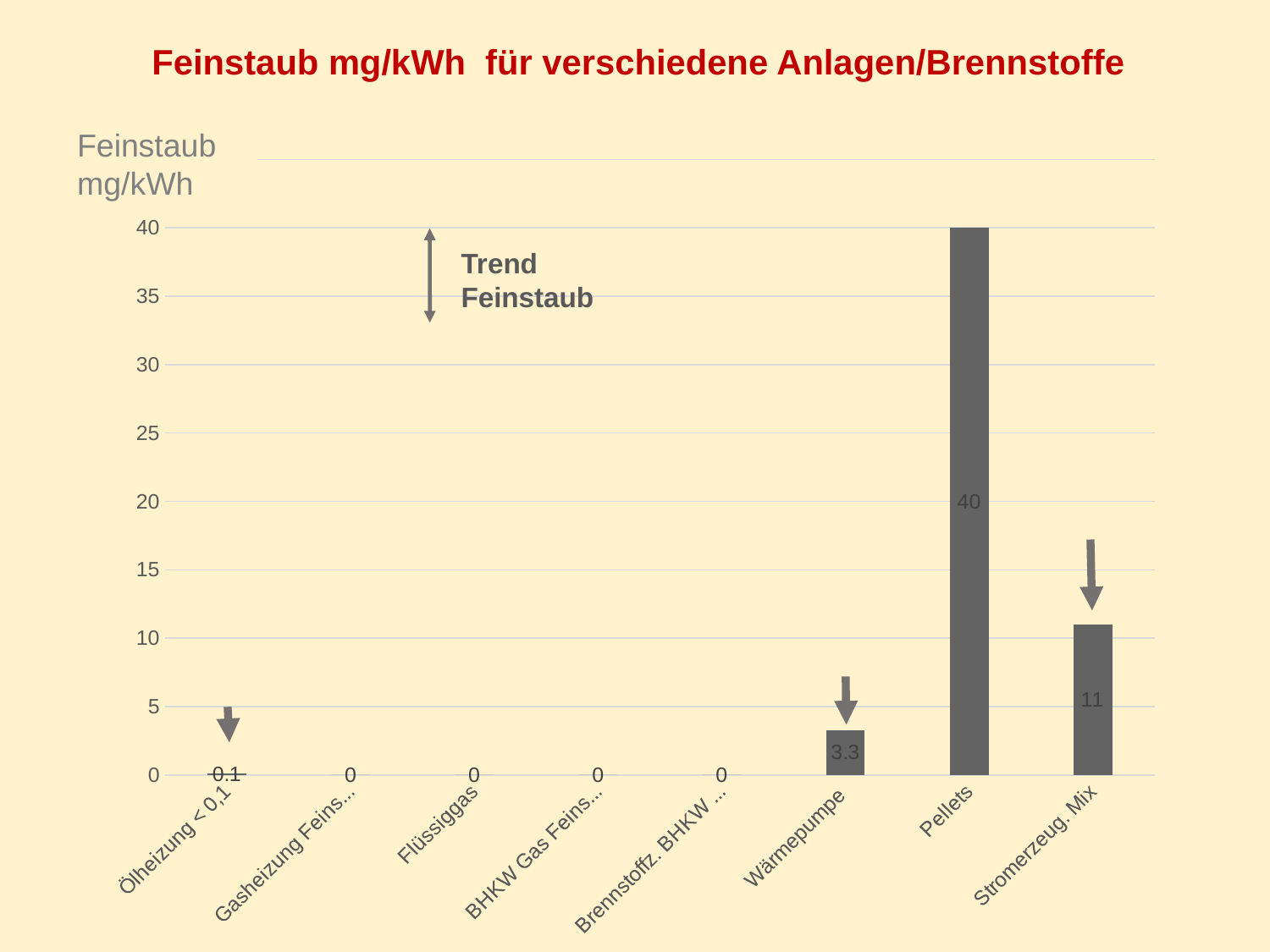
Which has a larger Feinstaub value, Wärmepumpe or Stromerzeug. Mix? Stromerzeug. Mix How many categories are shown on the x axis of the chart? 8 Which category has the highest Feinstaub value? Pellets What is the difference between the Feinstaub values for Pellets and Stromerzeug. Mix? 29 Is the Feinstaub value for Stromerzeug. Mix greater or less than 20? less What is the Feinstaub value for Pellets? 40 What is the Feinstaub value for Flüssiggas? 0 What is the Feinstaub value for Wärmepumpe? 3.3 What type of chart is shown on the slide? bar chart What is the Feinstaub value for Stromerzeug. Mix? 11 What is the title of the chart on the slide? Feinstaub mg/kWh für verschiedene Anlagen/Brennstoffe What is the difference between the Feinstaub values for Stromerzeug. Mix and Wärmepumpe? 7.7